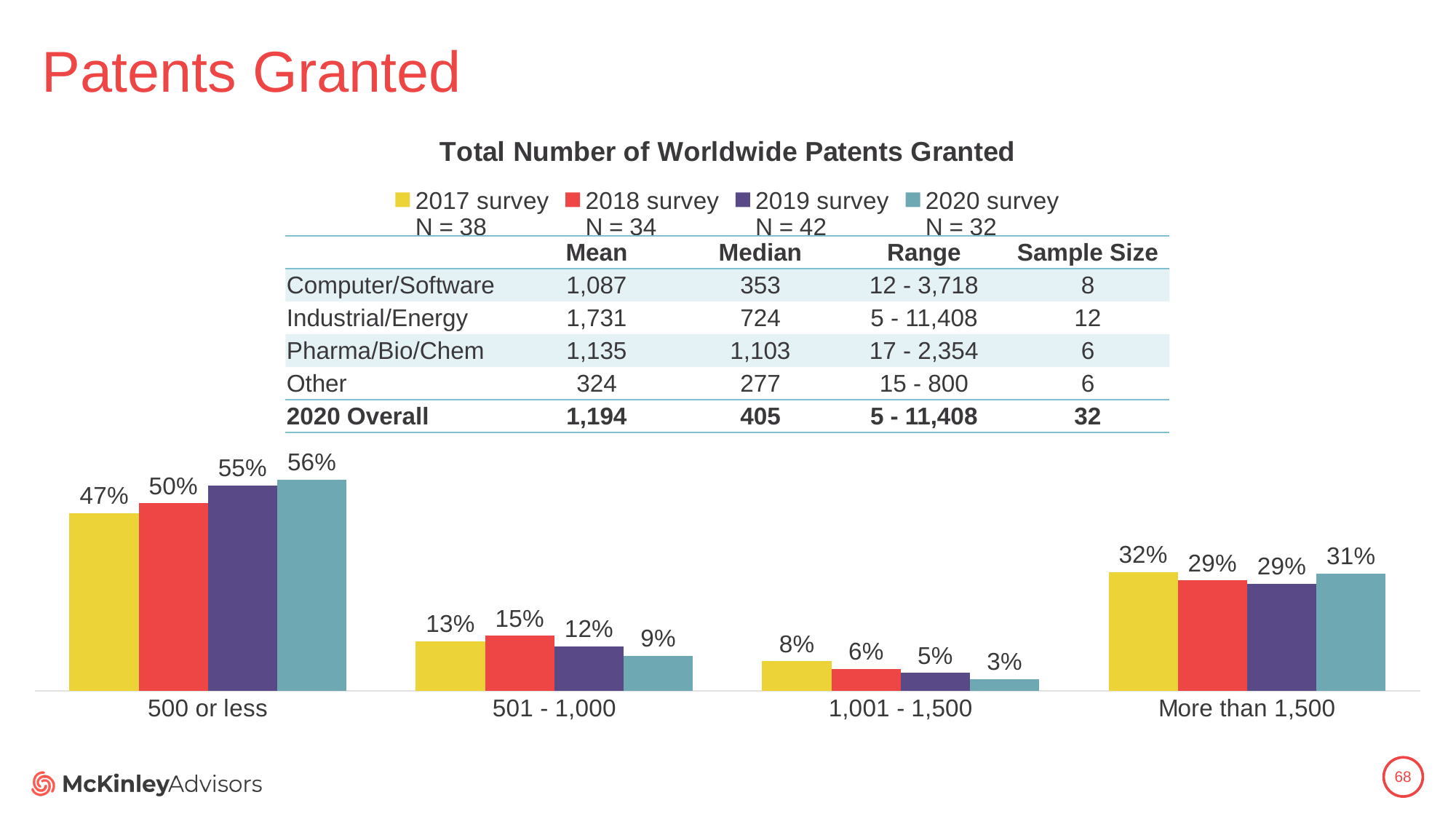
Which category has the lowest value for the 2020 survey? 1,001 - 1,500 Which category has the highest value for the 2019 survey? 500 or less What is the difference between the 2020 survey and 2017 survey values in the '500 or less' category? 9% What is the sample size (N) for the 2019 survey shown in the legend? N = 42 What is the value for the 2018 survey in the '501 - 1,000' category? 15% How many categories are shown on the x axis of the chart? 4 How many series does the chart legend list? 4 What kind of chart is shown on the slide? Bar chart What is the value for the 2020 survey in the '500 or less' category? 56% Which is larger in the '1,001 - 1,500' category: the 2017 survey value or the 2020 survey value? 2017 survey What is the value for the 2017 survey in the 'More than 1,500' category? 32% Across the four survey years, do the values in the '1,001 - 1,500' category rise or fall from the 2017 survey to the 2020 survey? Fall